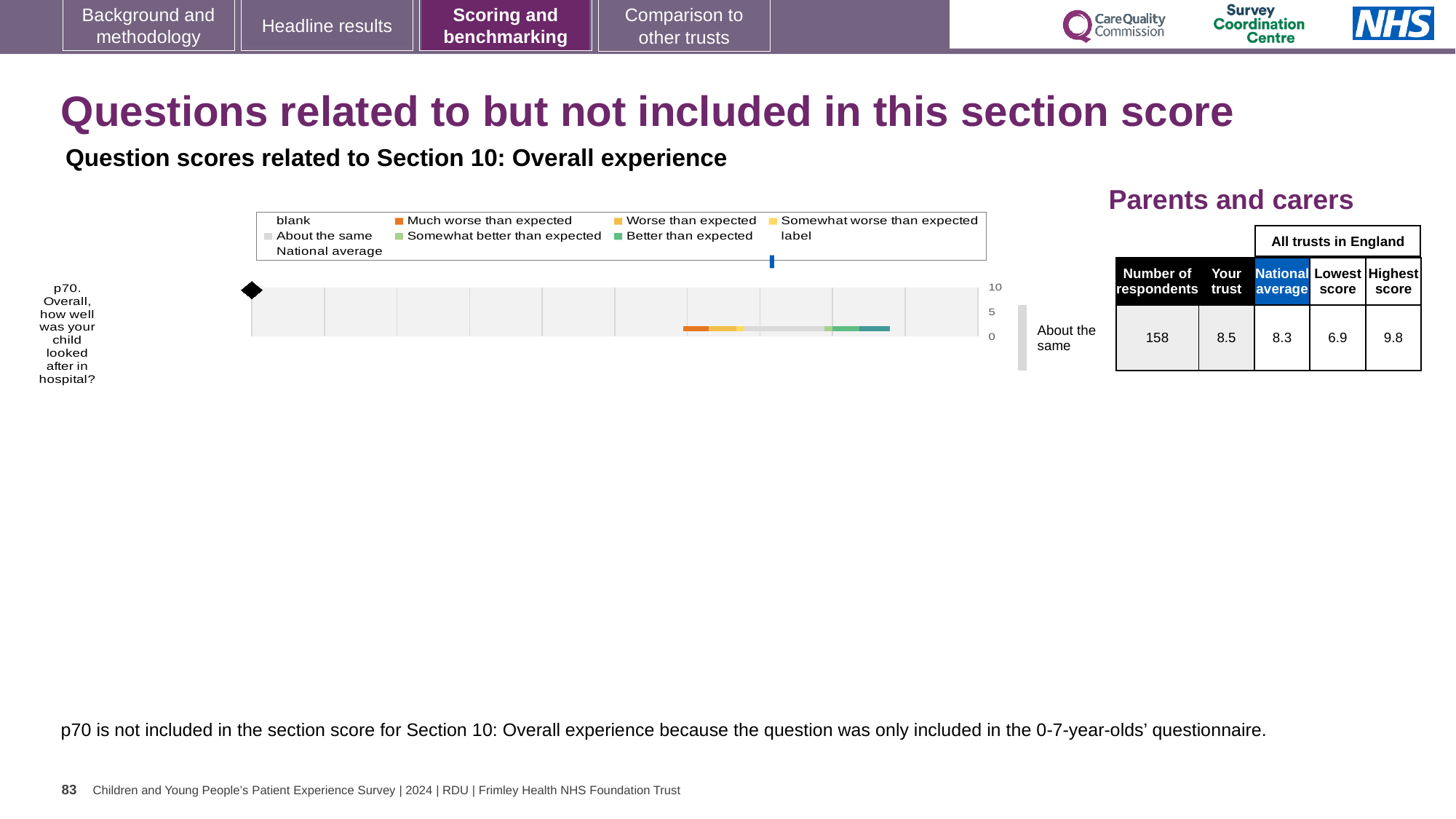
What is the highest value shown on the chart's axis? 10 How many questions (categories) are plotted in the chart? 1 What benchmark label is shown to the right of the bar for p70? About the same Which question is plotted in the chart? p70. Overall, how well was your child looked after in hospital? Which legend entry is shown in orange? Much worse than expected How many legend entries are listed for the chart? 9 What kind of chart is shown on the slide? bar chart